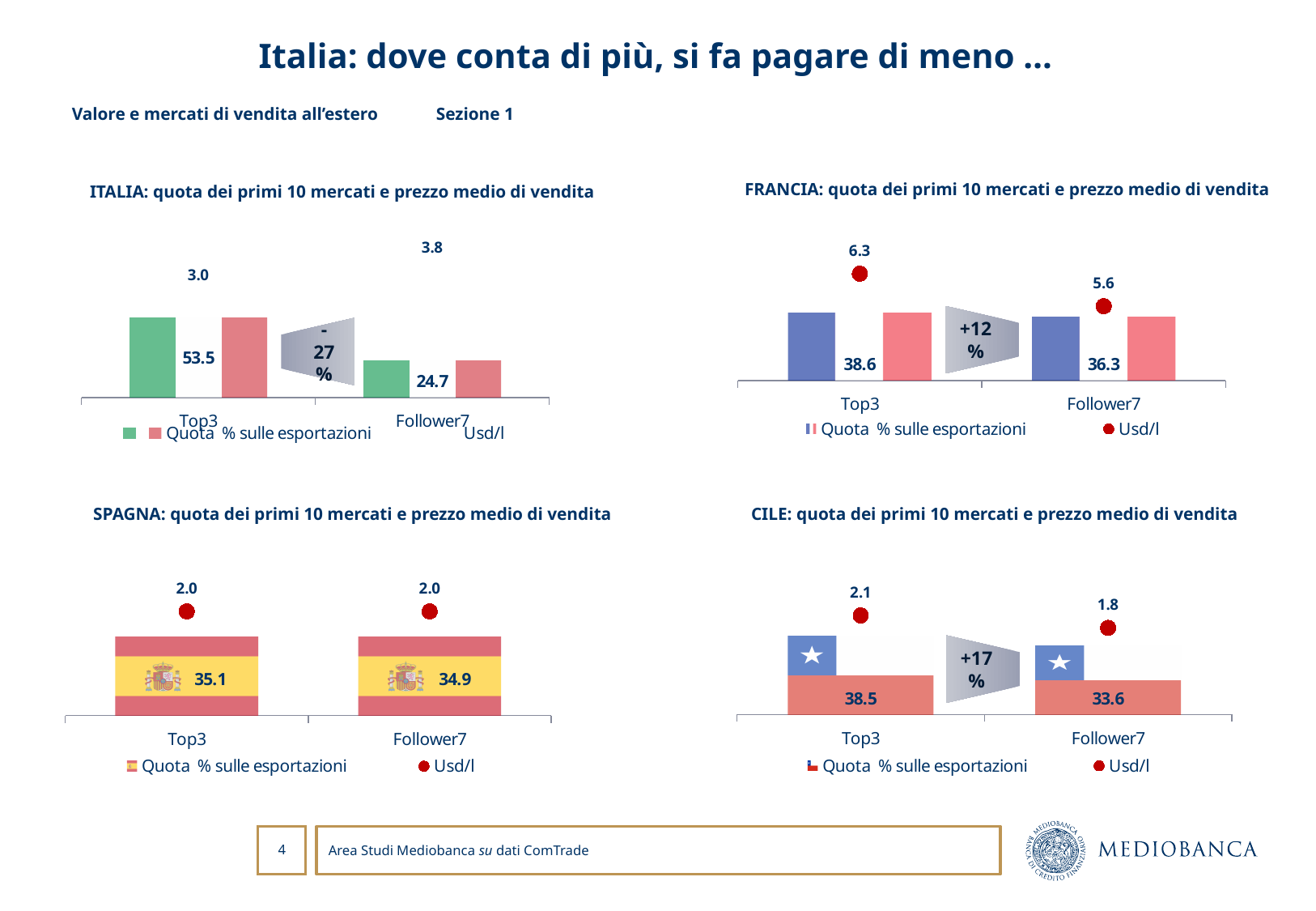
In the FRANCIA chart, which category has the higher Usd/l value? Top3 How many series does the legend of the CILE chart list? 2 In the CILE chart, what is the Usd/l value for Follower7? 1.8 In the ITALIA chart, does the Usd/l value rise or fall from Top3 to Follower7? rise In the FRANCIA chart, what is the Quota % sulle esportazioni for Follower7? 36.3 In the ITALIA chart, what is the difference in Quota % sulle esportazioni between Top3 and Follower7? 28.8 In the SPAGNA chart, what is the Quota % sulle esportazioni for Top3? 35.1 In the FRANCIA chart, what is the Usd/l value for Top3? 6.3 How many categories are shown on the x axis of the SPAGNA chart? 2 In the ITALIA chart, what is the Usd/l value for Follower7? 3.8 In the ITALIA chart, what is the Quota % sulle esportazioni for Top3? 53.5 In the CILE chart, which category has the higher Quota % sulle esportazioni, Top3 or Follower7? Top3